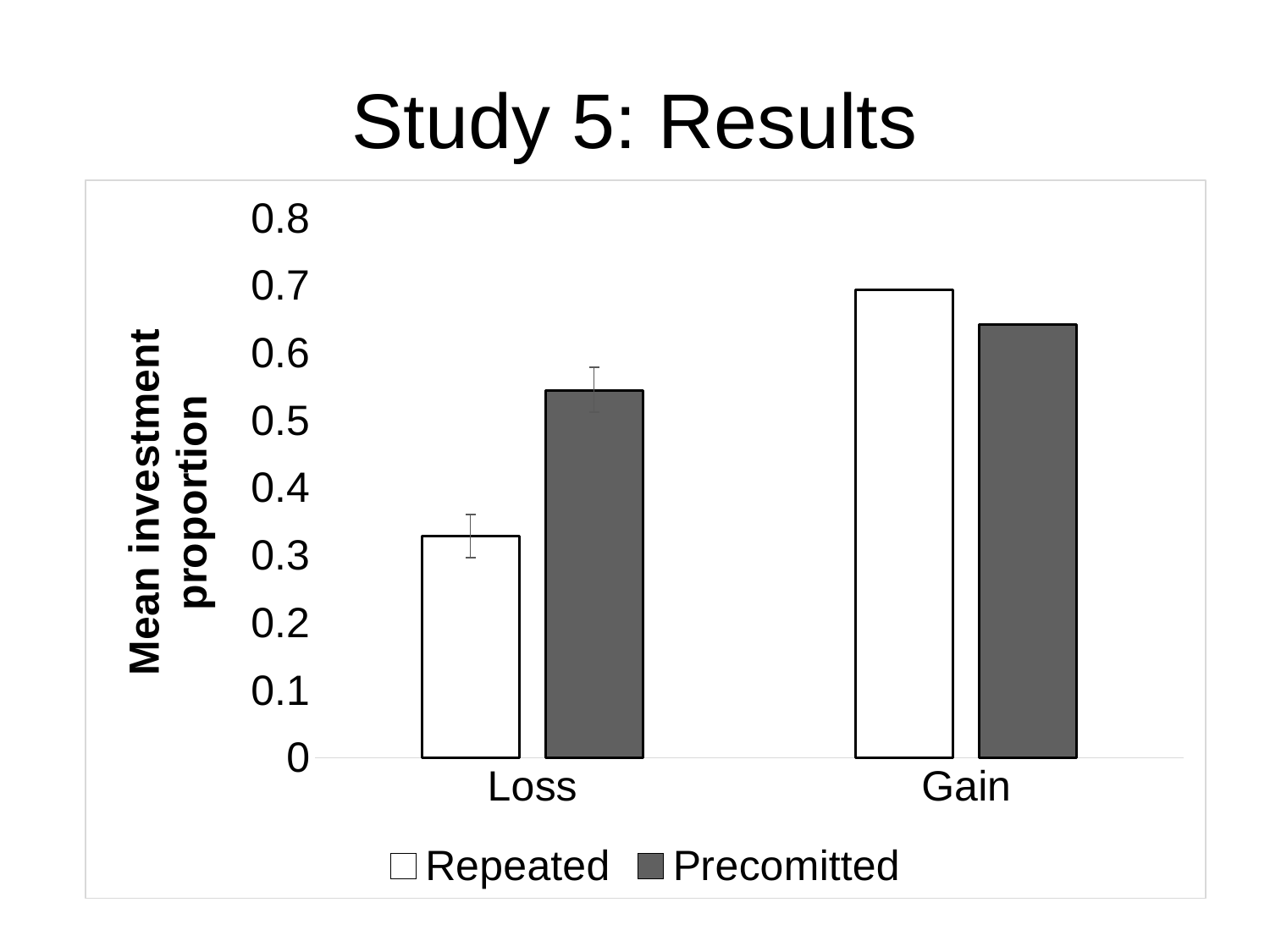
Which bar is the tallest in the chart? Repeated in Gain In the Gain condition, which series has the larger value, Repeated or Precomitted? Repeated Is the Repeated value for Loss greater or less than 0.4? less How many categories are shown on the x axis? 2 Is the Precomitted value for Gain greater or less than 0.7? less Which bar is the shortest in the chart? Repeated in Loss What is the label of the y axis? Mean investment proportion How many series does the legend list? 2 Is the Precomitted value for Loss greater or less than 0.5? greater What kind of chart is shown on the slide? bar chart In the Loss condition, which series has the larger value, Repeated or Precomitted? Precomitted